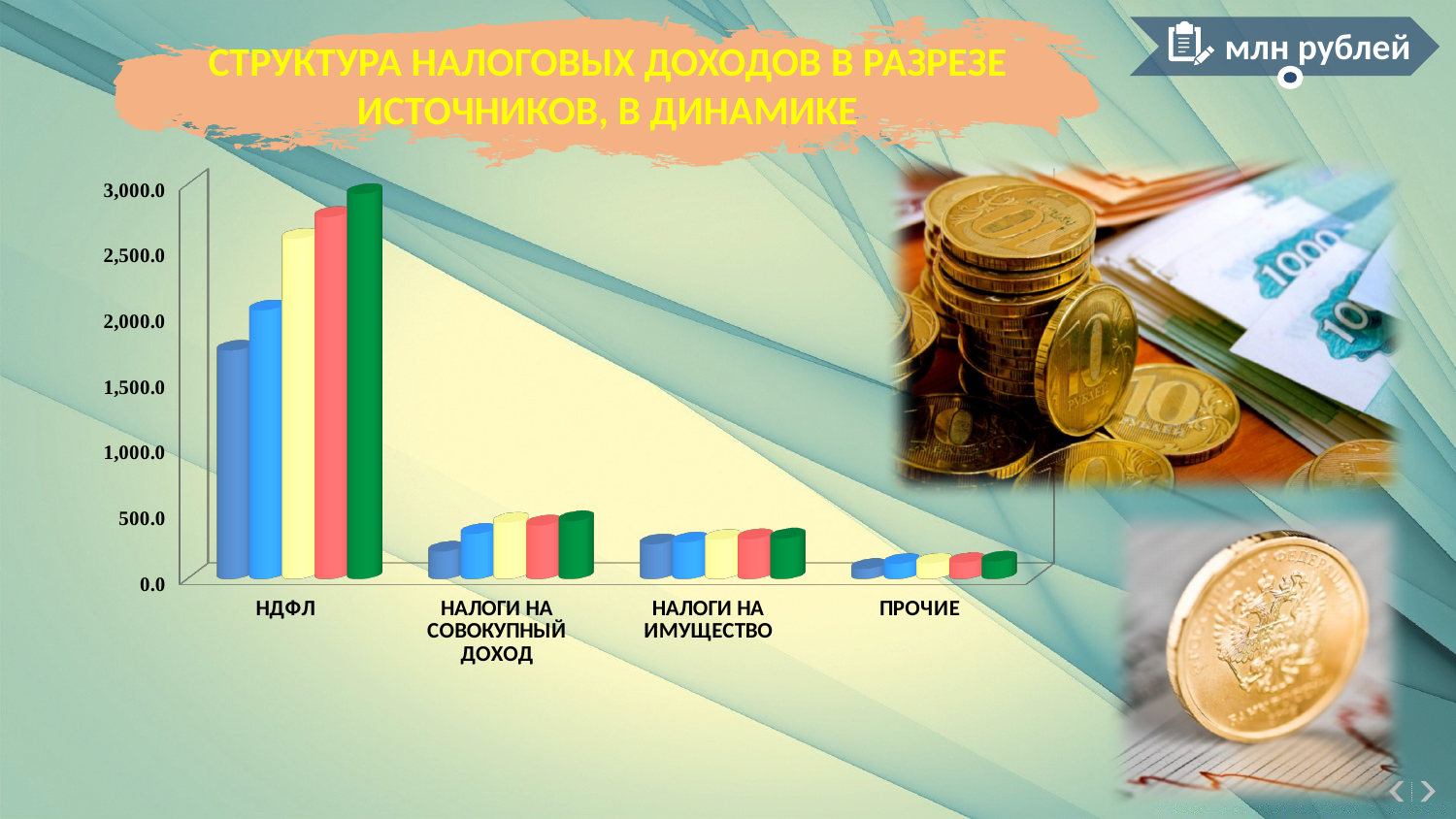
Is the value of the first (dark blue) bar for НДФЛ greater or less than 2,000? less Which category has larger values: НАЛОГИ НА ИМУЩЕСТВО or ПРОЧИЕ? НАЛОГИ НА ИМУЩЕСТВО How many categories are shown on the x axis of the chart? 4 Which category has the lowest values in the chart? ПРОЧИЕ Is the value of the green bar for НАЛОГИ НА СОВОКУПНЫЙ ДОХОД greater or less than 500? less What kind of chart is shown on the slide? Bar chart Is the value of the tallest (green) bar for НДФЛ greater or less than 2,500? greater Do the bars for НДФЛ rise or fall from the first bar to the last bar? rise Which category has the highest values in the chart? НДФЛ How many bars are plotted for each category in the chart? 5 In what units are the values of the chart expressed, according to the slide? млн рублей